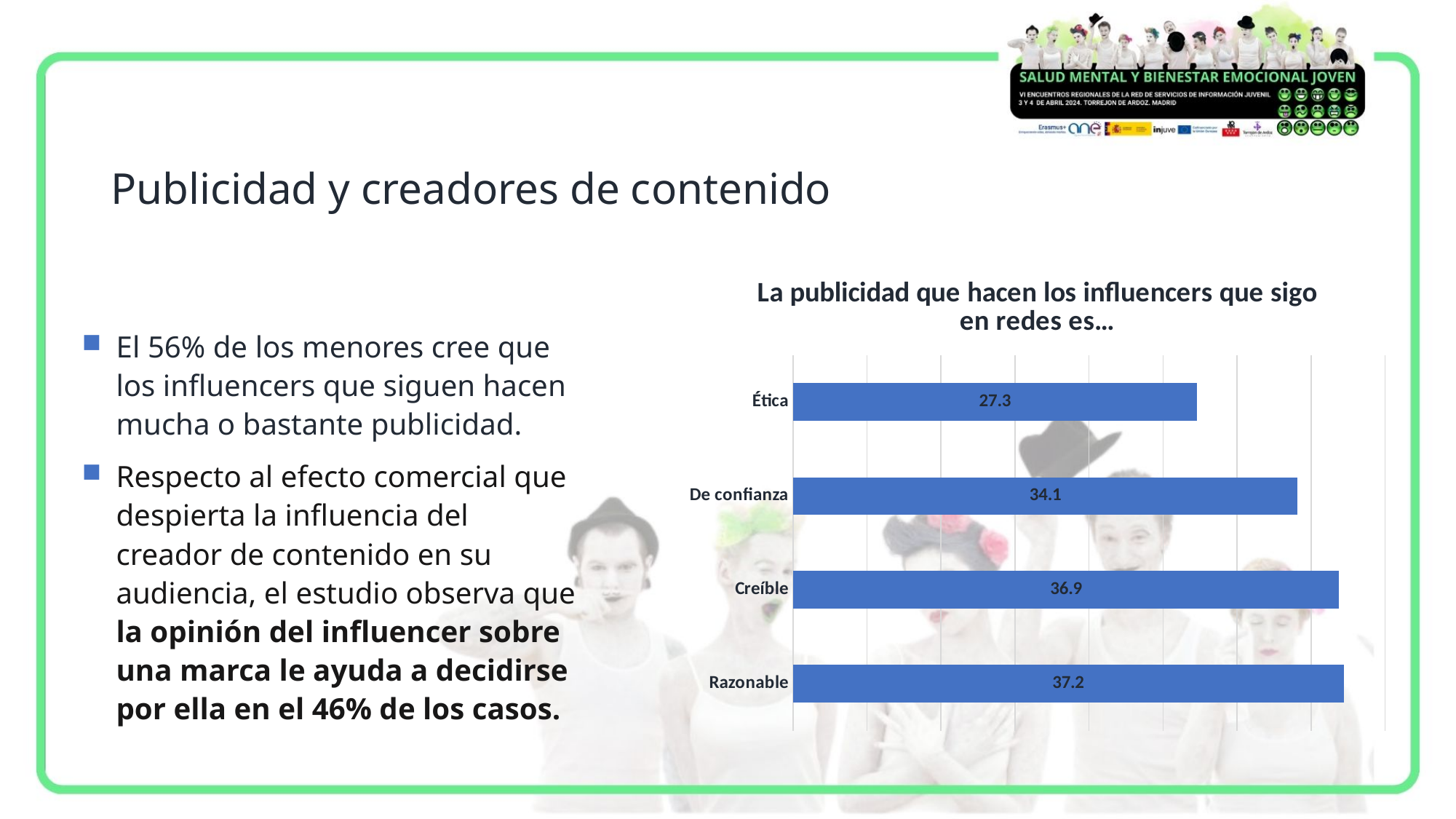
What is the title of the chart? La publicidad que hacen los influencers que sigo en redes es… Which is larger, the value for Creíble or the value for De confianza? Creíble Which category has the lowest value? Ética What is the value for Creíble? 36.9 How many categories are shown in the chart? 4 Which is larger, the value for De confianza or the value for Ética? De confianza What kind of chart is shown on the slide? Bar chart What is the value for Ética? 27.3 What is the difference between the values for De confianza and Ética? 6.8 What is the value for De confianza? 34.1 What is the difference between the values for Razonable and Ética? 9.9 What is the value for Razonable? 37.2